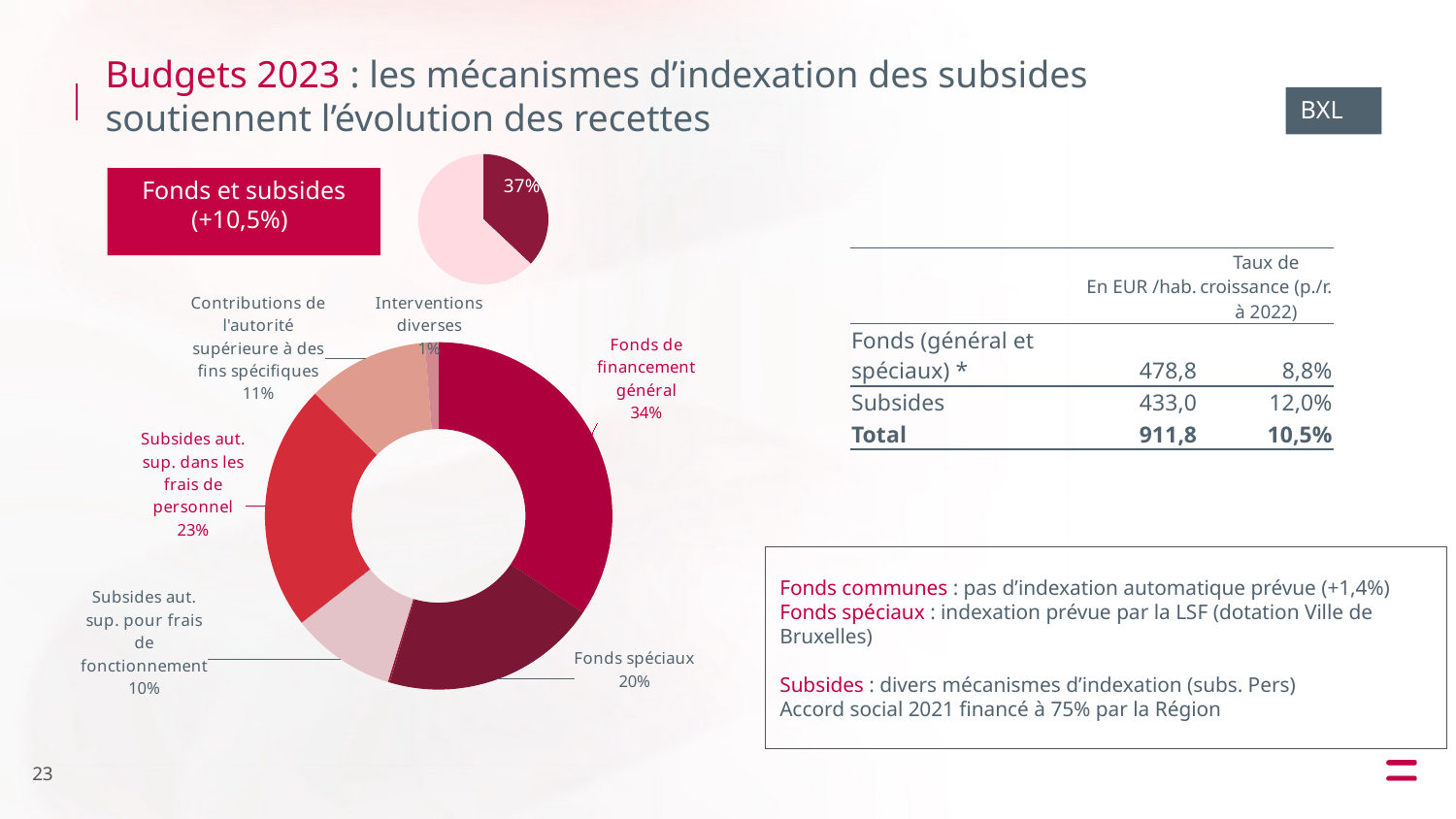
On the large donut chart, which category has the smallest share? Interventions diverses How many categories are shown on the large donut chart? 6 On the large donut chart, which is larger: Subsides aut. sup. dans les frais de personnel or Contributions de l'autorité supérieure à des fins spécifiques? Subsides aut. sup. dans les frais de personnel On the large donut chart, what share is labelled for Subsides aut. sup. pour frais de fonctionnement? 10% On the large donut chart, which category has the largest share? Fonds de financement général What kind of chart is the large chart on the left of the slide? Donut chart On the small pie chart at the top of the slide, what percentage is labelled on the dark slice? 37% On the large donut chart, what share is labelled for Fonds de financement général? 34% On the large donut chart, what share is labelled for Subsides aut. sup. dans les frais de personnel? 23% On the large donut chart, what share is labelled for Interventions diverses? 1% On the large donut chart, what is the difference in percentage points between Fonds de financement général and Fonds spéciaux? 14 On the large donut chart, what share is labelled for Fonds spéciaux? 20%